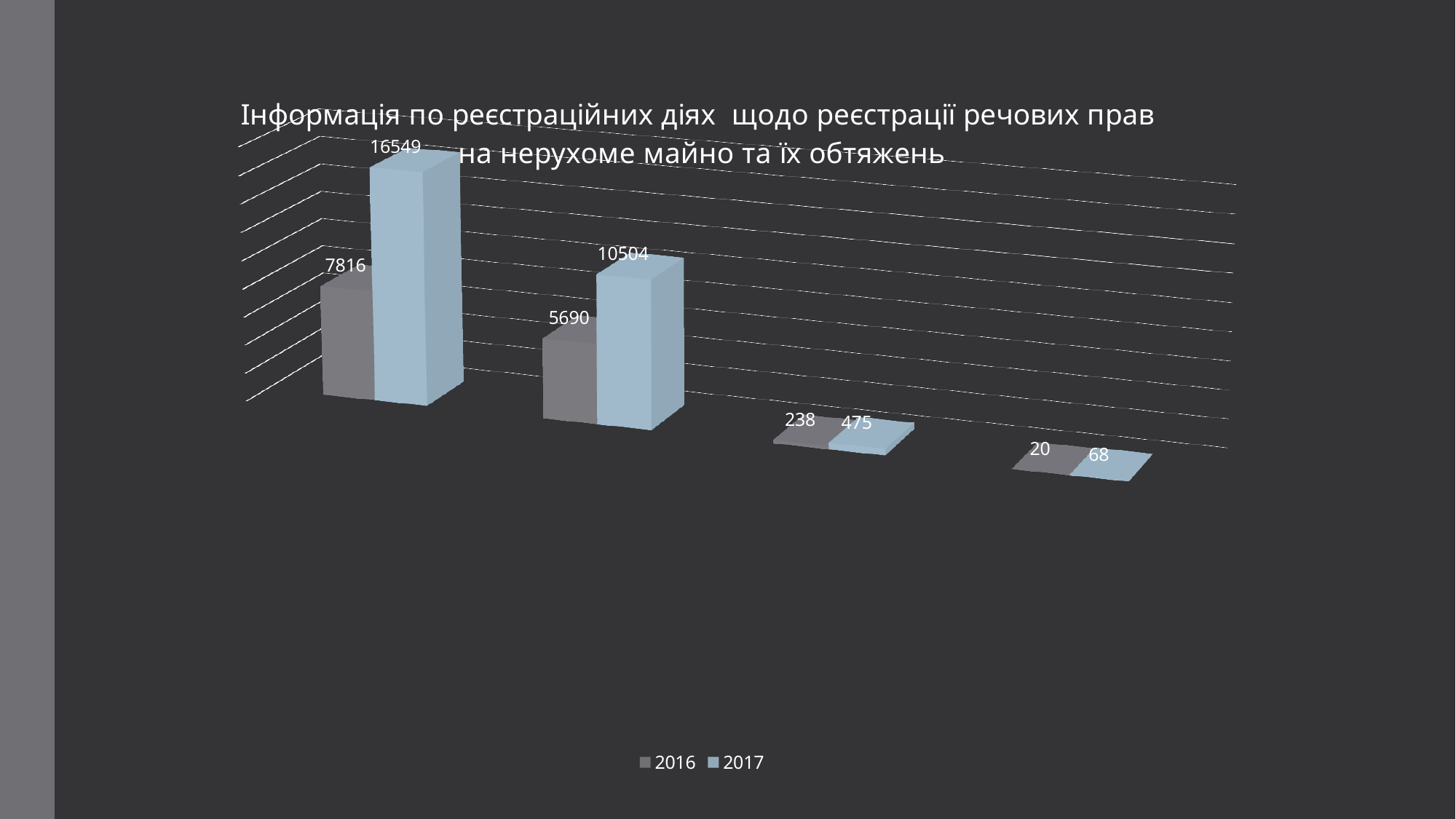
How many series does the legend list? 2 In the second group of bars from the left, which is larger, the 2016 value or the 2017 value? 2017 What kind of chart is shown on the slide? bar chart What is the 2017 value for the fourth (rightmost) group of bars? 68 What is the 2017 value for the second group of bars from the left? 10504 What is the lowest value shown in the chart? 20 What is the difference between the 2017 and 2016 values in the first (leftmost) group of bars? 8733 Which series has the highest value in the chart, 2016 or 2017? 2017 What is the 2016 value for the first (leftmost) group of bars? 7816 What is the 2016 value for the third group of bars from the left? 238 How many groups of bars are plotted in the chart? 4 What is the 2017 value for the first (leftmost) group of bars? 16549